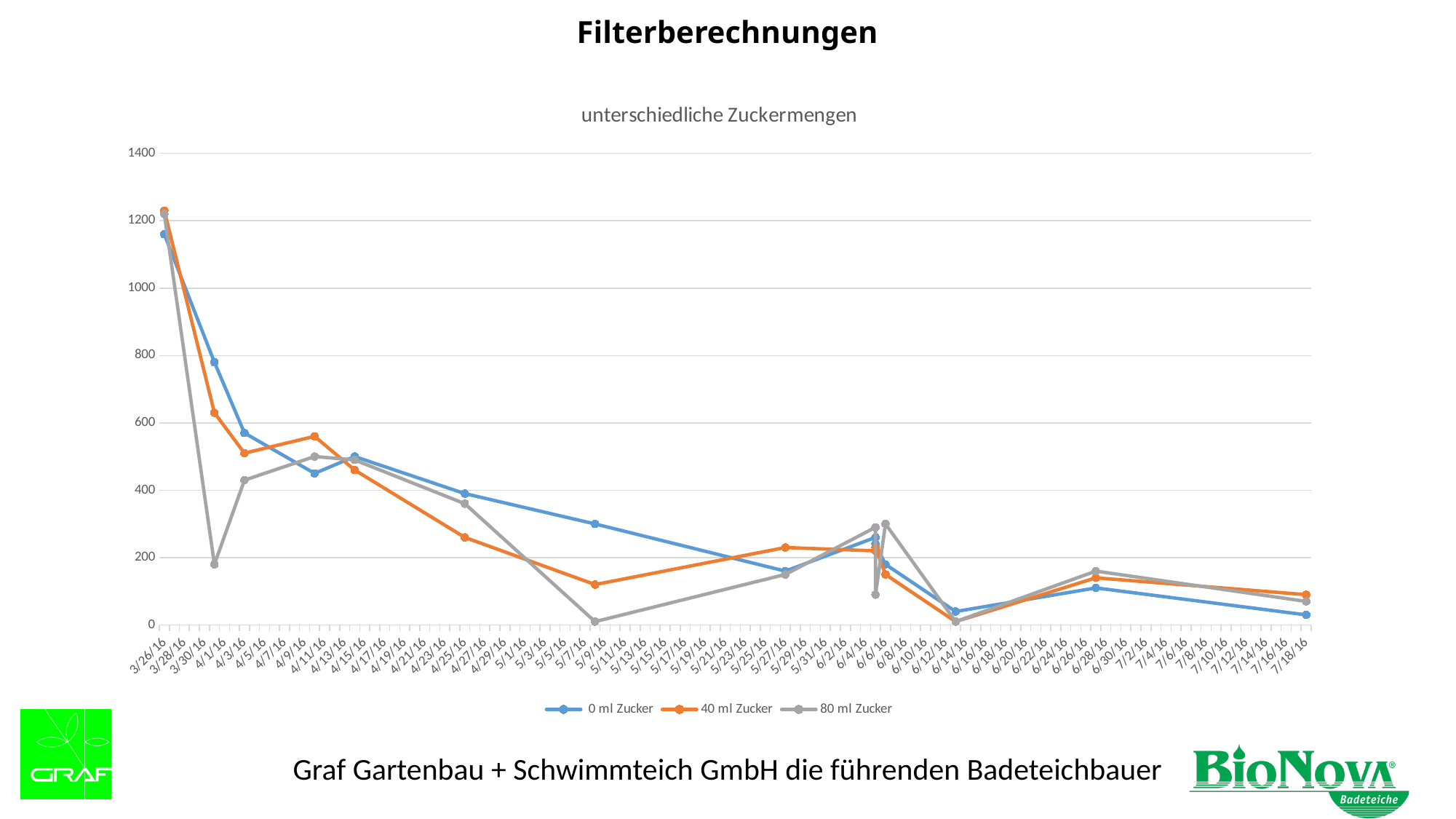
Which colour is used for the 80 ml Zucker series? grey What kind of chart is shown on the slide? line chart Is the value for 0 ml Zucker on 7/18/16 greater or less than 200? less How many series does the legend list? 3 Do the values for 0 ml Zucker generally rise or fall from 3/26/16 to 7/18/16? fall What is the subtitle shown above the chart's plot area? unterschiedliche Zuckermengen